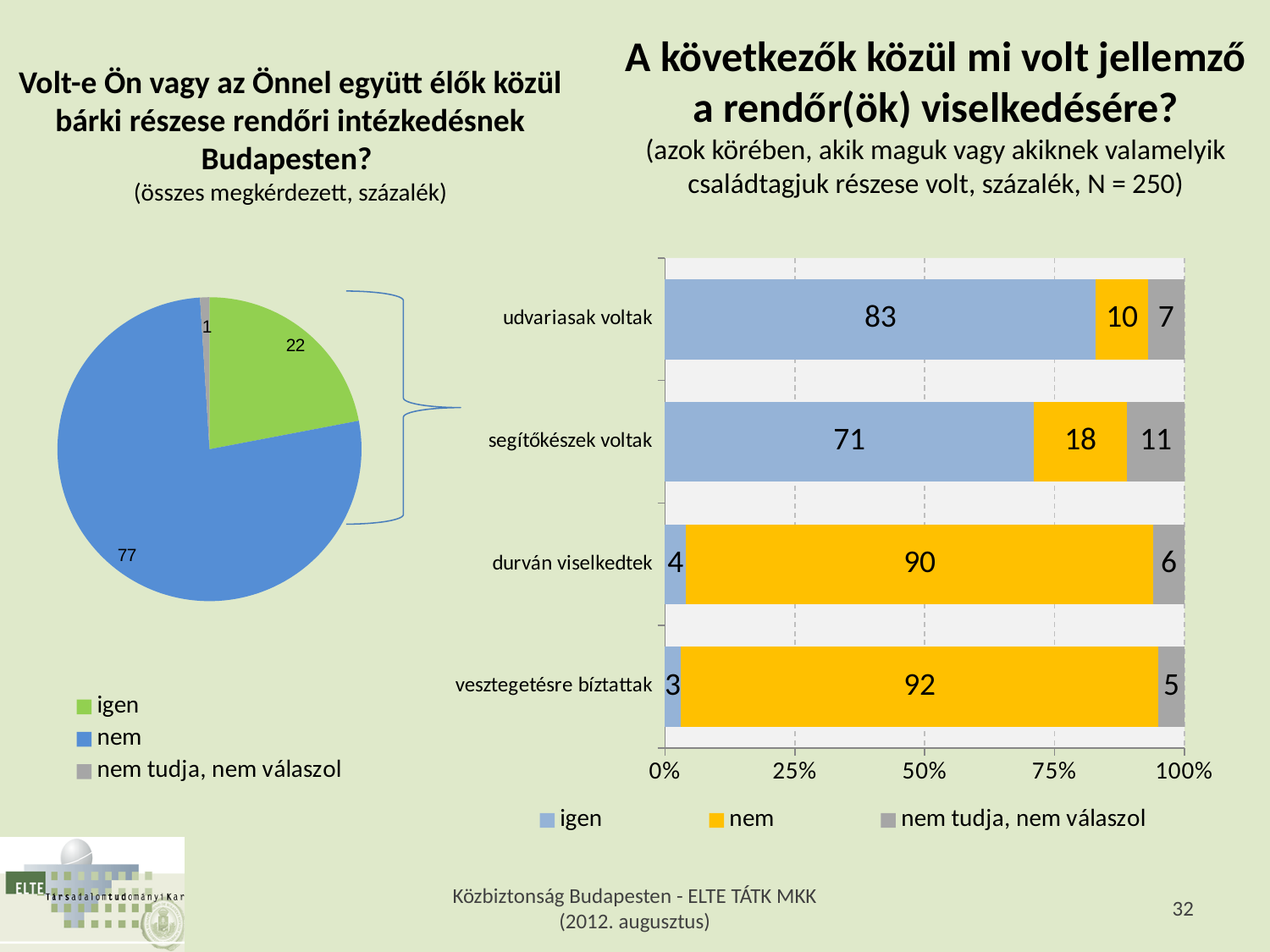
In the bar chart on the right, is the "igen" value for "udvariasak voltak" or for "durván viselkedtek" larger? udvariasak voltak In the bar chart on the right, which category has the highest "nem" value? vesztegetésre bíztattak In the pie chart on the left, which category has the largest slice? nem In the bar chart on the right, how many series does the legend list? 3 What kind of chart is shown on the right side of the slide? stacked bar chart In the pie chart on the left, how many categories does the legend list? 3 In the pie chart on the left, which category has the smallest slice? nem tudja, nem válaszol In the bar chart on the right, what is the "nem" value for "durván viselkedtek"? 90 In the bar chart on the right, what is the difference between the "igen" values for "udvariasak voltak" and "segítőkészek voltak"? 12 In the bar chart on the right, what is the "igen" value for "udvariasak voltak"? 83 In the bar chart on the right, what is the "nem tudja, nem válaszol" value for "segítőkészek voltak"? 11 In the pie chart on the left, what is the value for "igen"? 22